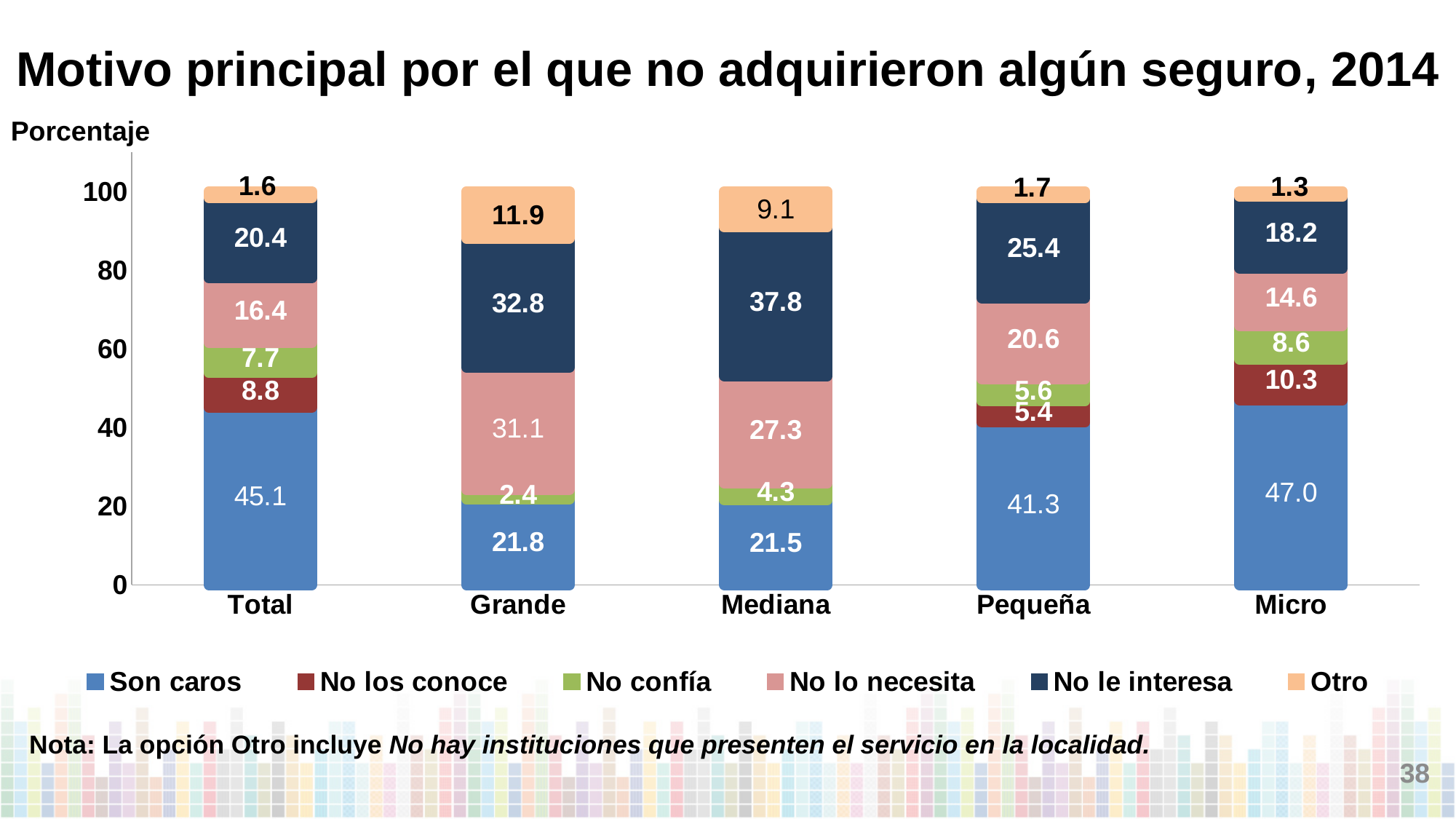
What is the value of 'No lo necesita' for Pequeña? 20.6 How many series does the legend list? 6 What is the value of 'Otro' for Grande? 11.9 Which is larger: 'No lo necesita' for Grande or 'No lo necesita' for Mediana? Grande What is the value of 'Son caros' for Micro? 47.0 Which category has the lowest value for 'Otro'? Micro What type of chart is shown on the slide? Stacked bar chart Which category has the highest value for 'Son caros'? Micro What is the value of 'No le interesa' for Mediana? 37.8 What is the total of the stacked bar for Pequeña? 100.0 How many categories are shown on the x axis? 5 What is the difference between the 'No le interesa' values for Mediana and Total? 17.4